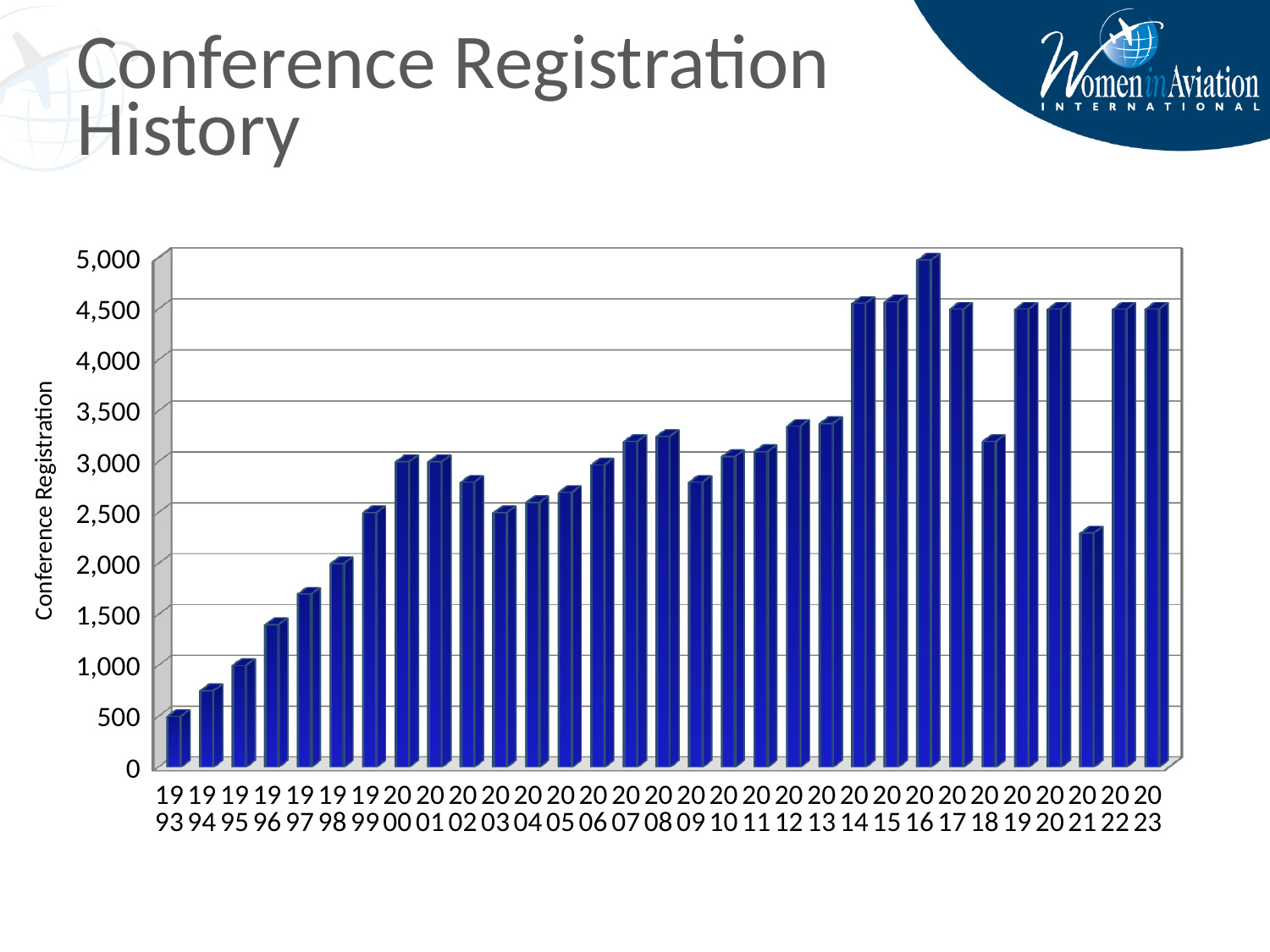
Is the value for 2009 greater or less than 3,000? less Which year has the larger conference registration, 2018 or 2021? 2018 How many years are plotted on the x axis of the chart? 31 Is the value for 2021 greater or less than 2,500? less What is the title of the vertical axis of the chart? Conference Registration Do the values rise or fall from 1993 to 1999? rise Is the value for 2014 greater or less than 4,000? greater What kind of chart is shown on the slide? bar chart Which year has the lowest conference registration? 1993 Which year has the highest conference registration? 2016